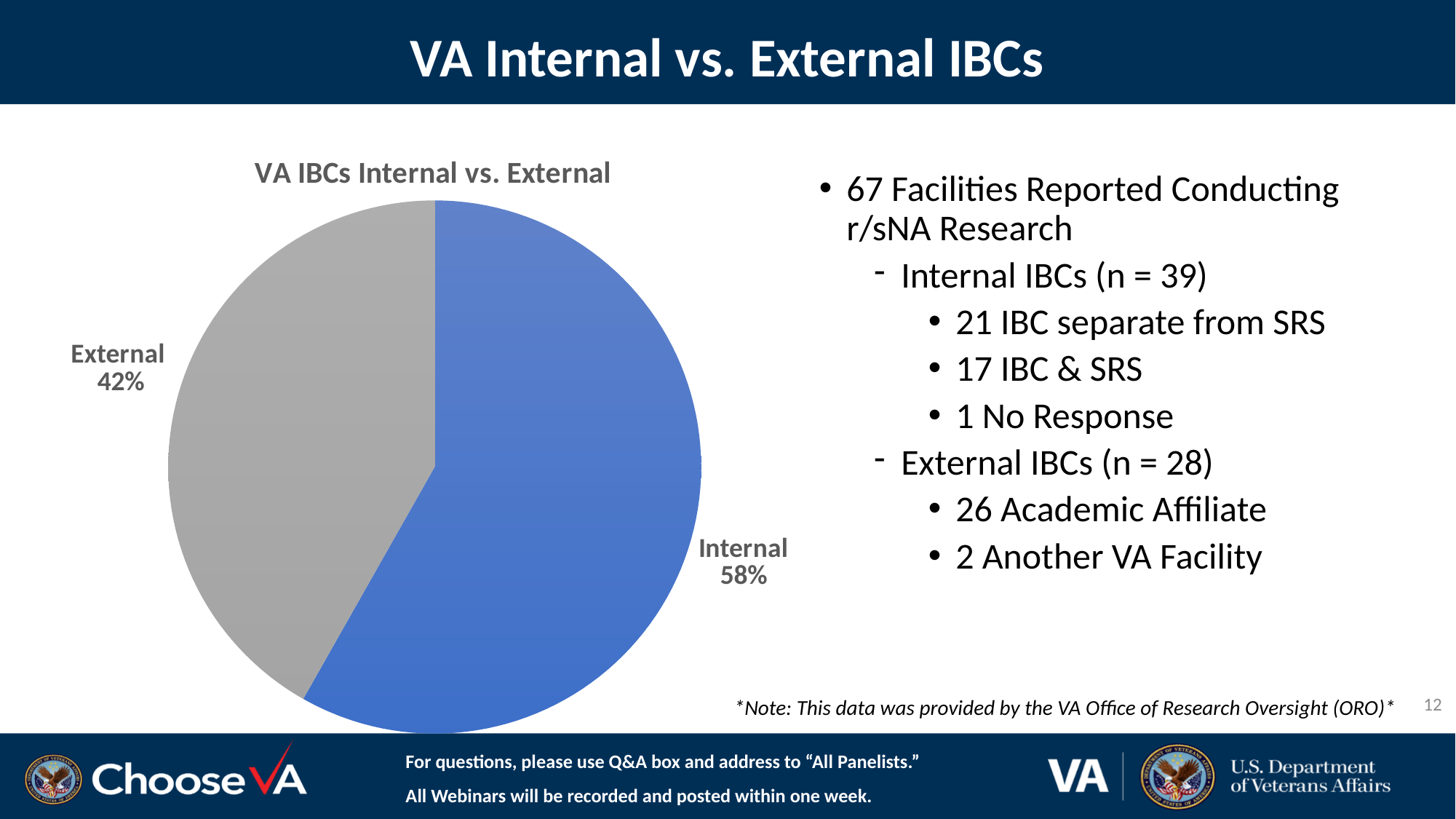
What kind of chart is shown on the slide? Pie chart What colour is the Internal slice of the pie? Blue What is the title of the chart? VA IBCs Internal vs. External Which slice of the pie is the smallest? External What is the difference in percentage points between the Internal and External slices? 16 percentage points What share of the pie does the External slice represent? 42% How many slices does the pie chart have? 2 What share of the pie does the Internal slice represent? 58% Which is larger, the Internal slice or the External slice? Internal Which slice of the pie is the largest? Internal Is the share for External greater or less than 50%? less